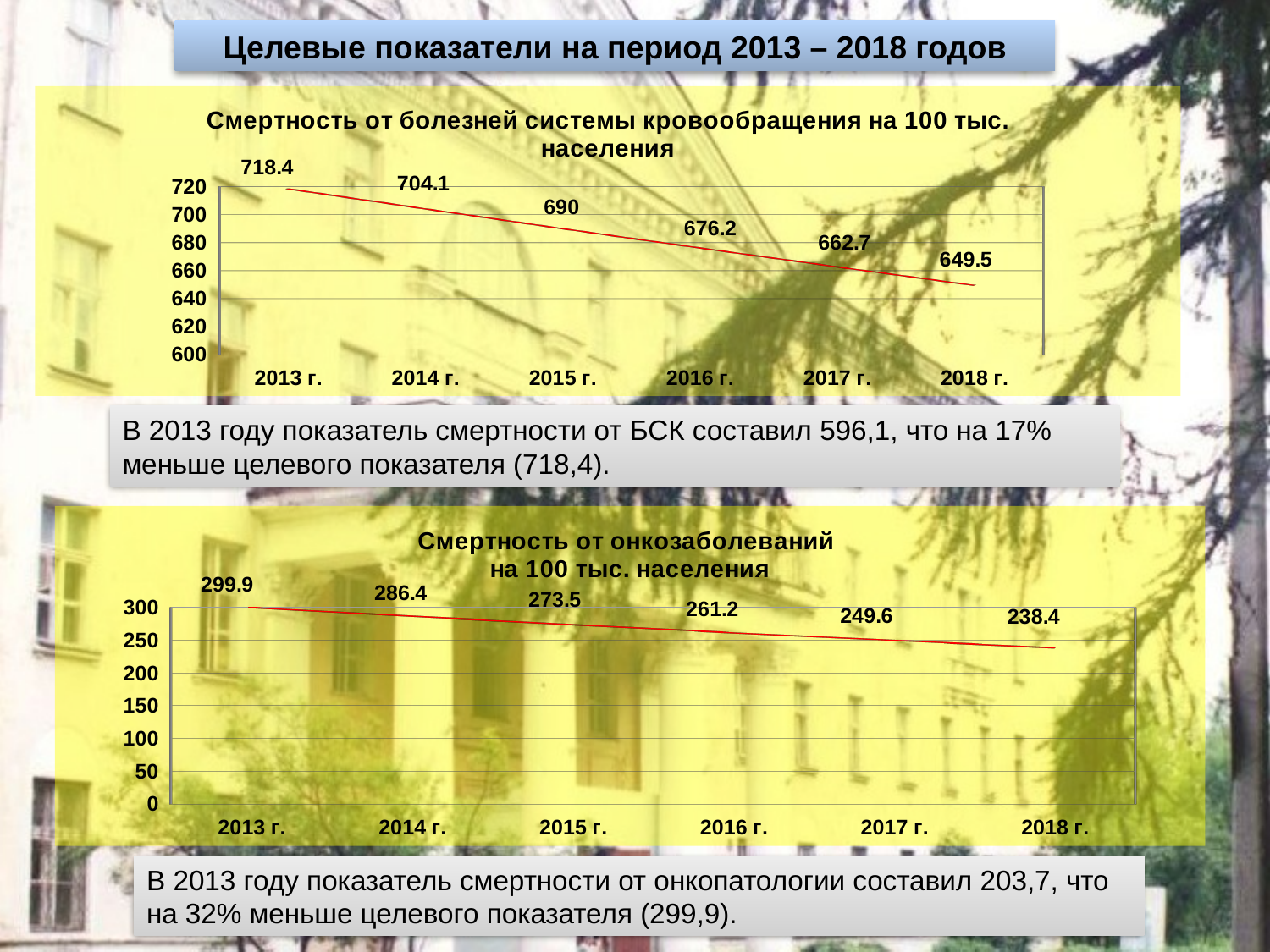
In the bottom chart (Смертность от онкозаболеваний), which is larger: the value for 2014 г. or the value for 2017 г.? 2014 г. What type of chart is the bottom chart (Смертность от онкозаболеваний)? line chart In the bottom chart (Смертность от онкозаболеваний), what is the value for 2018 г.? 238.4 In the top chart (Смертность от болезней системы кровообращения), which year has the lowest value? 2018 г. In the top chart (Смертность от болезней системы кровообращения), what is the value for 2016 г.? 676.2 In the top chart (Смертность от болезней системы кровообращения), what is the difference between the 2013 г. and 2018 г. values? 68.9 In the top chart (Смертность от болезней системы кровообращения), how many years are plotted? 6 In the bottom chart (Смертность от онкозаболеваний), what is the value for 2015 г.? 273.5 In the bottom chart (Смертность от онкозаболеваний), which year has the highest value? 2013 г. In the top chart (Смертность от болезней системы кровообращения), do the values rise or fall from 2013 г. to 2018 г.? fall In the bottom chart (Смертность от онкозаболеваний), what is the difference between the 2013 г. and 2014 г. values? 13.5 In the top chart (Смертность от болезней системы кровообращения), what is the value for 2013 г.? 718.4